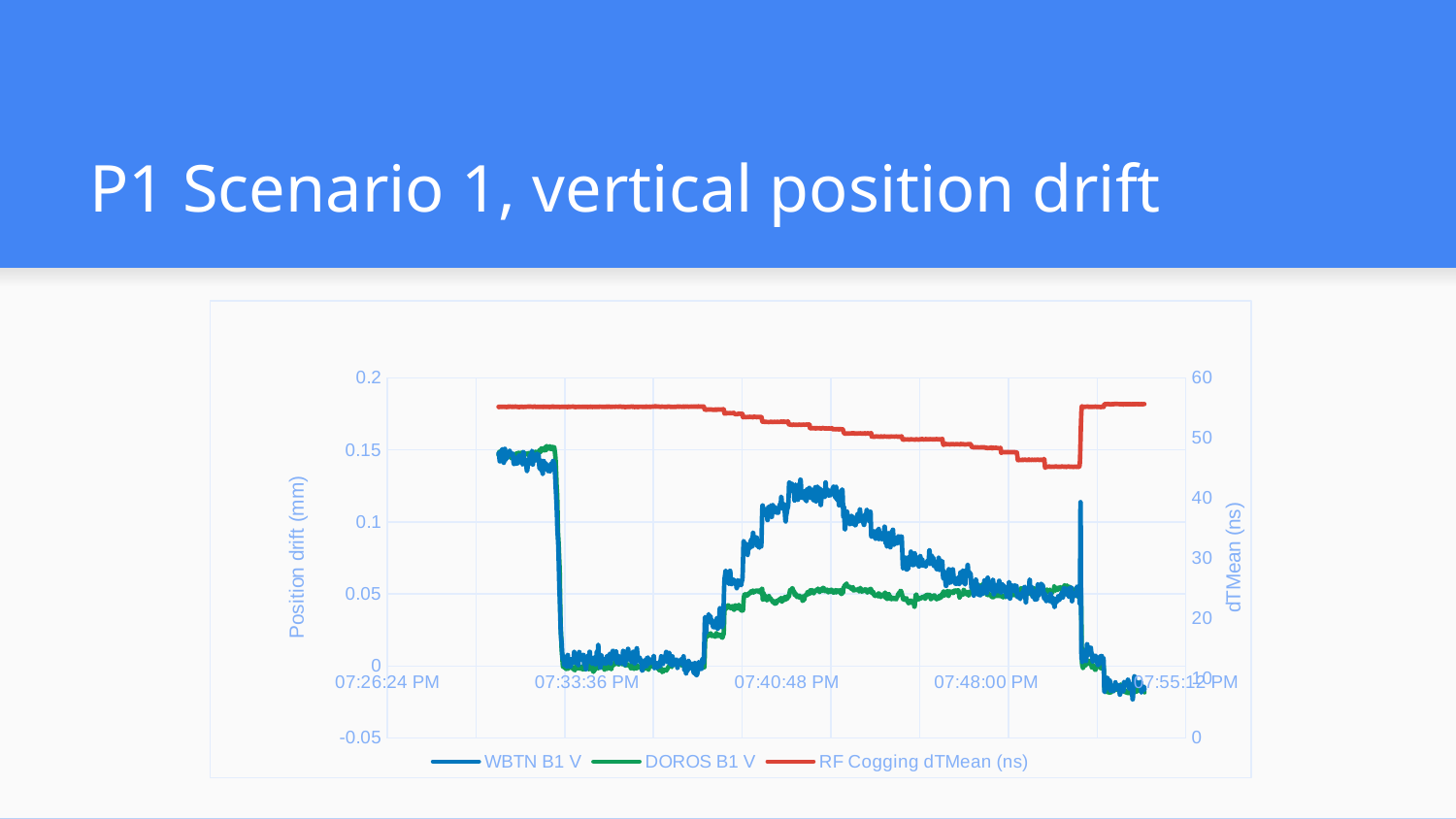
What is the title of the right vertical axis? dTMean (ns) How many series does the legend list? 3 How many time labels are shown on the x axis? 5 At 07:40:48 PM, which series has the higher position drift, WBTN B1 V or DOROS B1 V? WBTN B1 V Is the value of RF Cogging dTMean (ns) at 07:33:36 PM greater or less than 50? greater What kind of chart is shown on the slide? line chart What is the title of the left vertical axis? Position drift (mm) Is the value of RF Cogging dTMean (ns) at 07:48:00 PM greater or less than 40? greater Between 07:33:36 PM and 07:48:00 PM, does the RF Cogging dTMean (ns) series rise or fall? fall Is the value of DOROS B1 V at 07:48:00 PM greater or less than 0.1? less